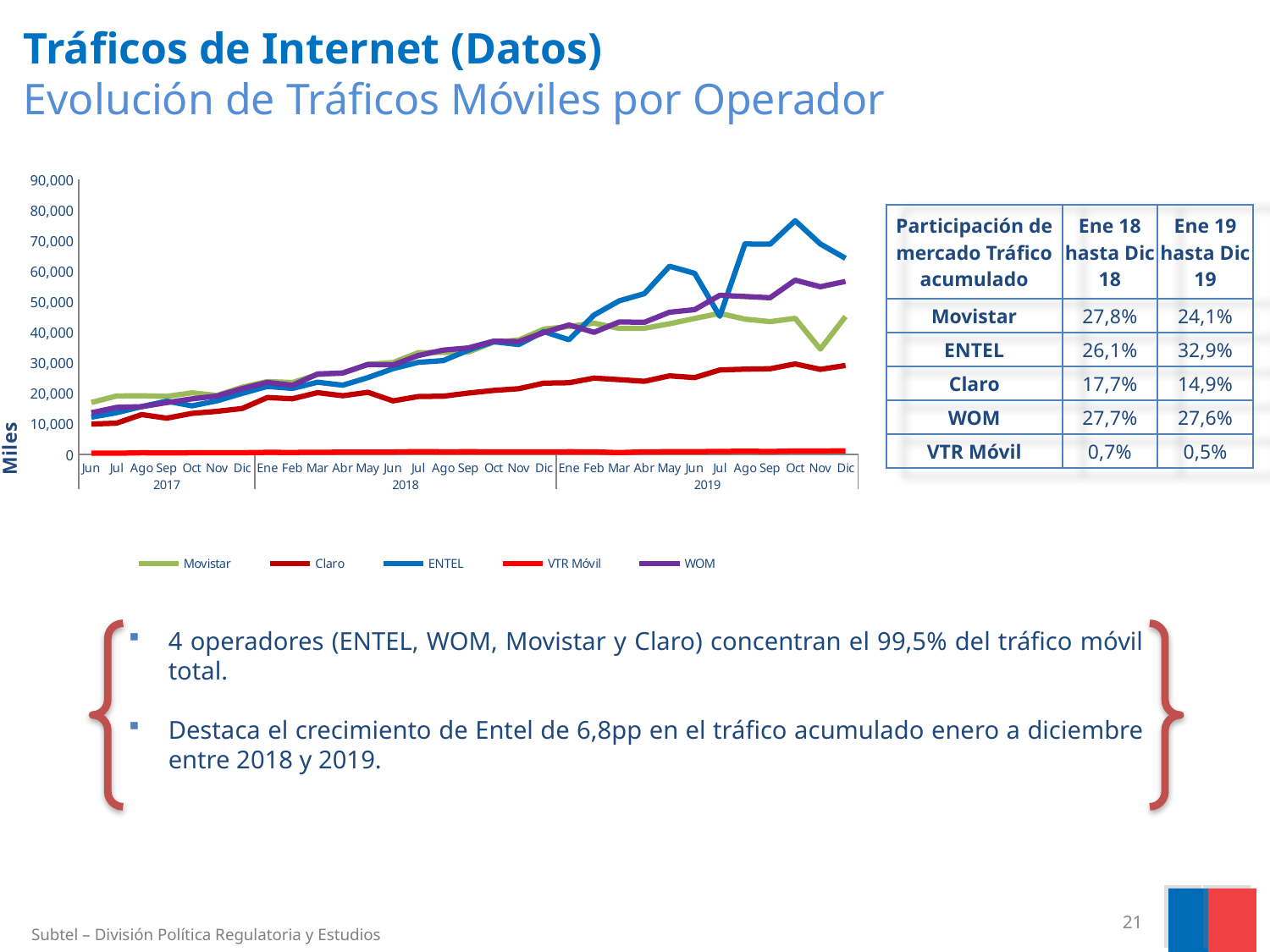
Which series has the lowest values throughout the chart? VTR Móvil Which operators are listed in the chart legend? Movistar, Claro, ENTEL, VTR Móvil, WOM How many series does the chart legend list? 5 Is the value for WOM in Dic 2019 greater or less than 50,000? greater What is the label on the vertical axis of the chart? Miles How many monthly data points are plotted along the x axis of the chart? 31 Does the ENTEL series generally rise or fall from Jun 2017 to Dic 2019? Rise Which series has the highest value at Dic 2019 in the chart? ENTEL What kind of chart is shown on the slide? Line chart At Dic 2019, which is larger in the chart: ENTEL or Claro? ENTEL Is the value for ENTEL in Oct 2019 greater or less than 70,000? greater Is the value for VTR Móvil in Dic 2019 greater or less than 10,000? less